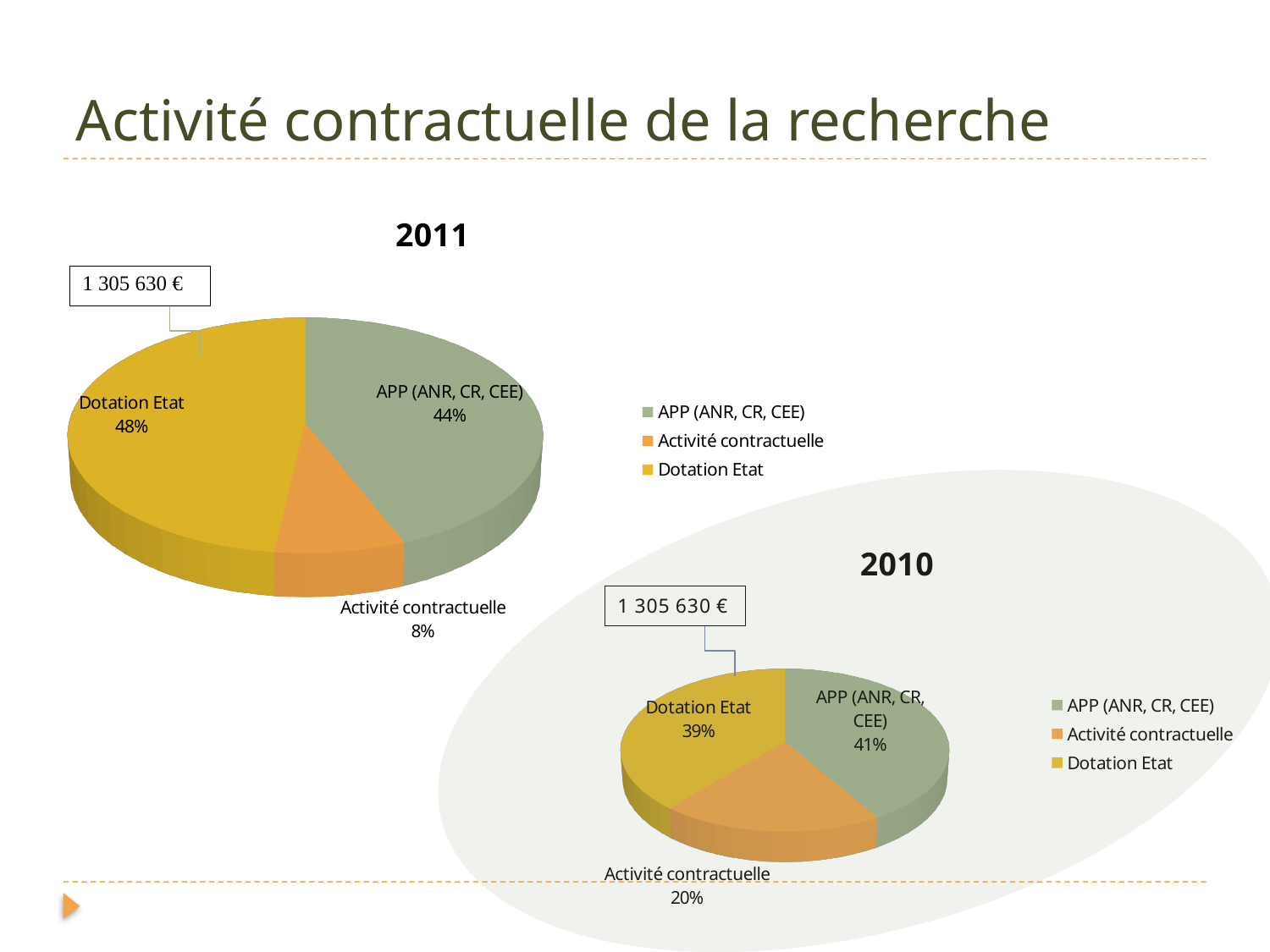
What kind of chart is the 2010 chart? Pie chart In the 2010 chart, which is larger: APP (ANR, CR, CEE) or Dotation Etat? APP (ANR, CR, CEE) How many categories does the 2011 chart show? 3 In the 2010 chart, what share does Dotation Etat have? 39% In the 2011 chart, which category has the smallest share? Activité contractuelle In the 2010 chart, what share does Activité contractuelle have? 20% In the 2011 chart, what share does Dotation Etat have? 48% In the 2011 chart, what share does APP (ANR, CR, CEE) have? 44% What amount is shown in the callout box attached to the Dotation Etat slice in the 2011 chart? 1 305 630 € In the 2010 chart, which category has the largest share? APP (ANR, CR, CEE) In the 2011 chart, what is the difference in percentage points between Dotation Etat and Activité contractuelle? 40 percentage points In the 2011 chart, what share does Activité contractuelle have? 8%